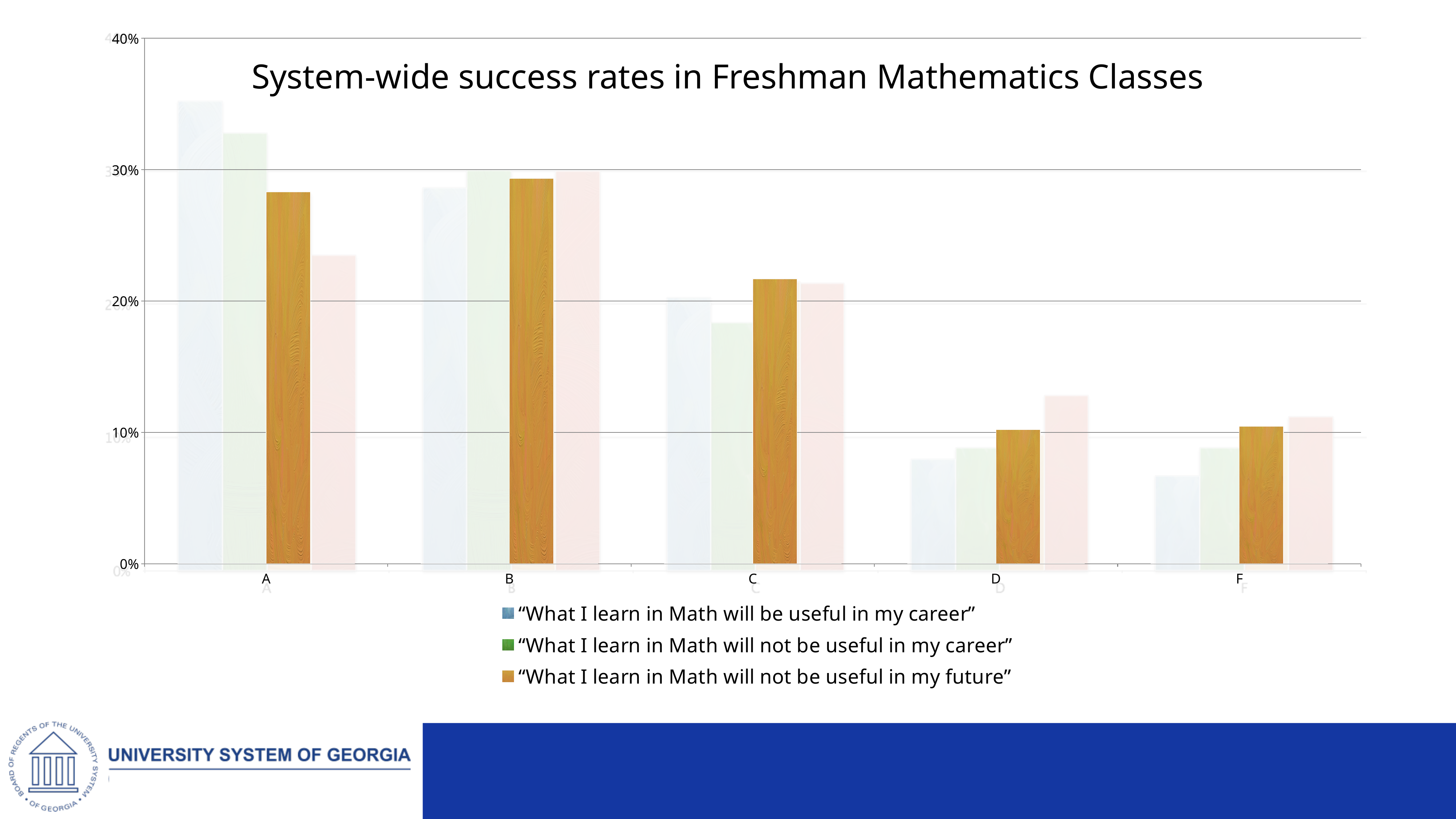
For the orange series ("What I learn in Math will not be useful in my future"), which is larger: the value for category C or the value for category D? C Is the value of the orange series ("What I learn in Math will not be useful in my future") for category F greater or less than 20%? less How many series does the chart's legend list? 3 Is the value of the orange series ("What I learn in Math will not be useful in my future") for category A greater or less than 30%? less How many categories are shown on the x axis of the chart? 5 Is the value of the orange series ("What I learn in Math will not be useful in my future") for category C greater or less than 30%? less Which series in the legend is shown in orange? "What I learn in Math will not be useful in my future" What is the title of the chart? System-wide success rates in Freshman Mathematics Classes For the orange series ("What I learn in Math will not be useful in my future"), which is larger: the value for category A or the value for category F? A What kind of chart is shown on the slide? bar chart